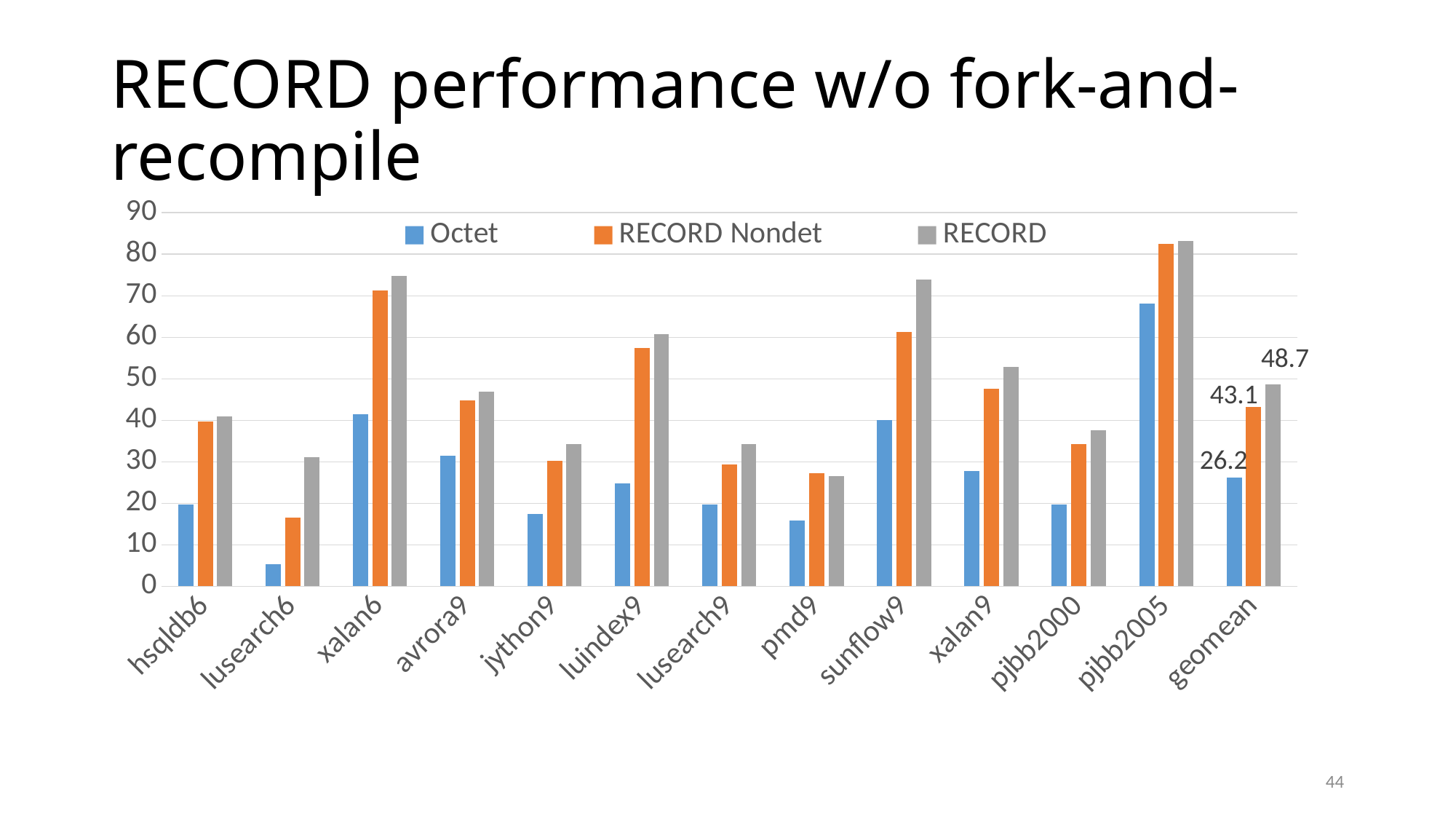
How many benchmark categories are shown on the x axis? 13 Which benchmark has the lowest Octet value? lusearch6 Which benchmark has the highest RECORD value? pjbb2005 For geomean, what is the difference between the RECORD value and the Octet value? 22.5 What is the value of the RECORD series for geomean? 48.7 Is the RECORD Nondet value for pjbb2005 greater or less than 70? greater Is the Octet value for pmd9 greater or less than 20? less What is the value of the RECORD Nondet series for geomean? 43.1 How many series does the legend list? 3 What is the value of the Octet series for geomean? 26.2 For sunflow9, which is larger: the Octet value or the RECORD value? RECORD For geomean, what is the difference between the RECORD value and the RECORD Nondet value? 5.6